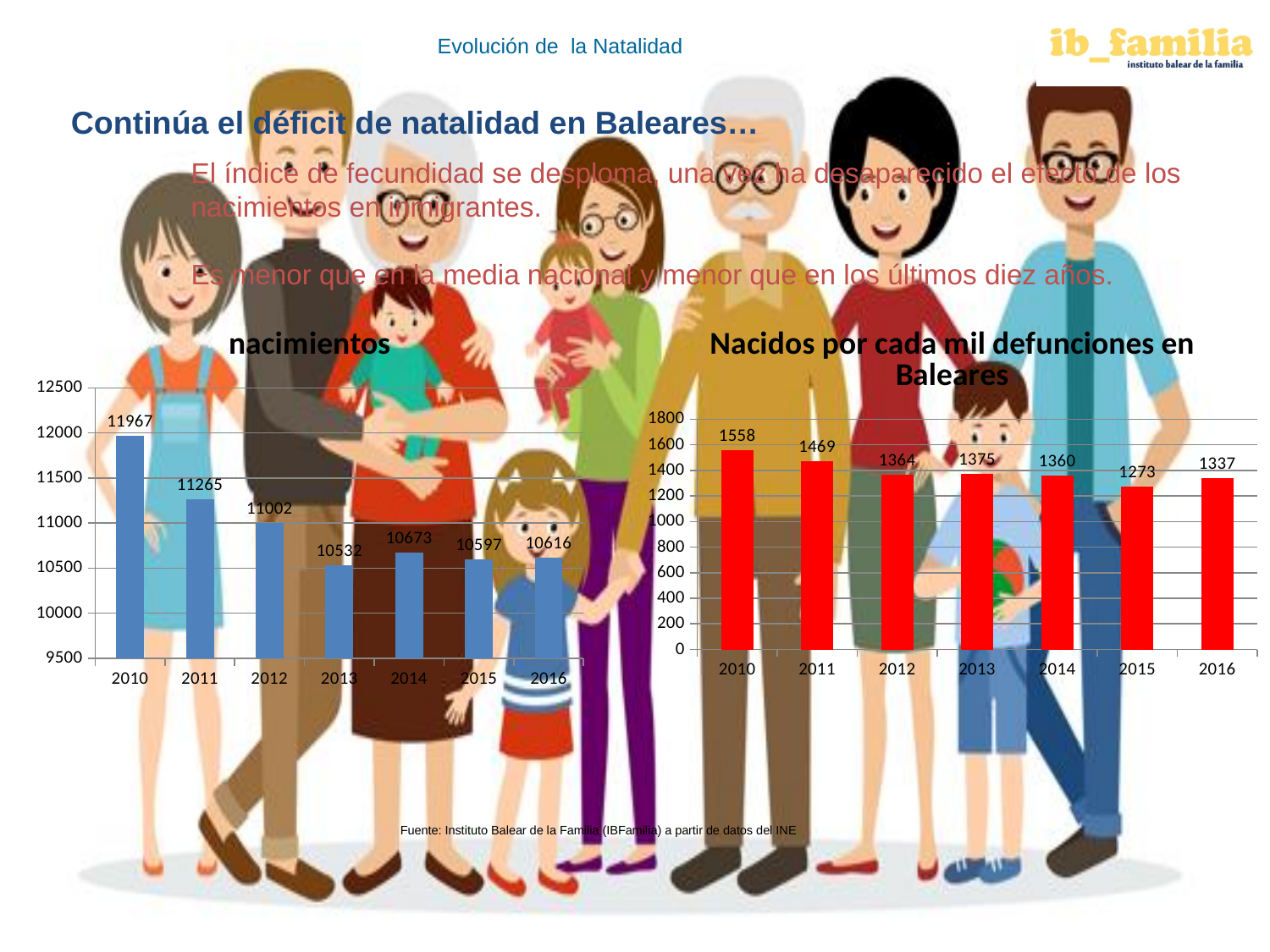
In the 'nacimientos' chart, which year has the lowest value? 2013 In the 'nacimientos' chart, what is the difference between the values for 2010 and 2016? 1351 What colour are the bars in the 'nacimientos' chart? blue In the 'nacimientos' chart, what is the value for 2013? 10532 In the 'Nacidos por cada mil defunciones en Baleares' chart, what is the value for 2015? 1273 In the 'nacimientos' chart, is the value for 2012 greater or less than 11000? greater In the 'Nacidos por cada mil defunciones en Baleares' chart, which year has the highest value? 2010 What type of chart is the 'Nacidos por cada mil defunciones en Baleares' chart? bar chart In the 'nacimientos' chart, what is the value for 2010? 11967 In the 'nacimientos' chart, how many years are shown on the x axis? 7 In the 'Nacidos por cada mil defunciones en Baleares' chart, which is larger, the value for 2013 or the value for 2016? 2013 In the 'Nacidos por cada mil defunciones en Baleares' chart, what is the difference between the values for 2010 and 2011? 89